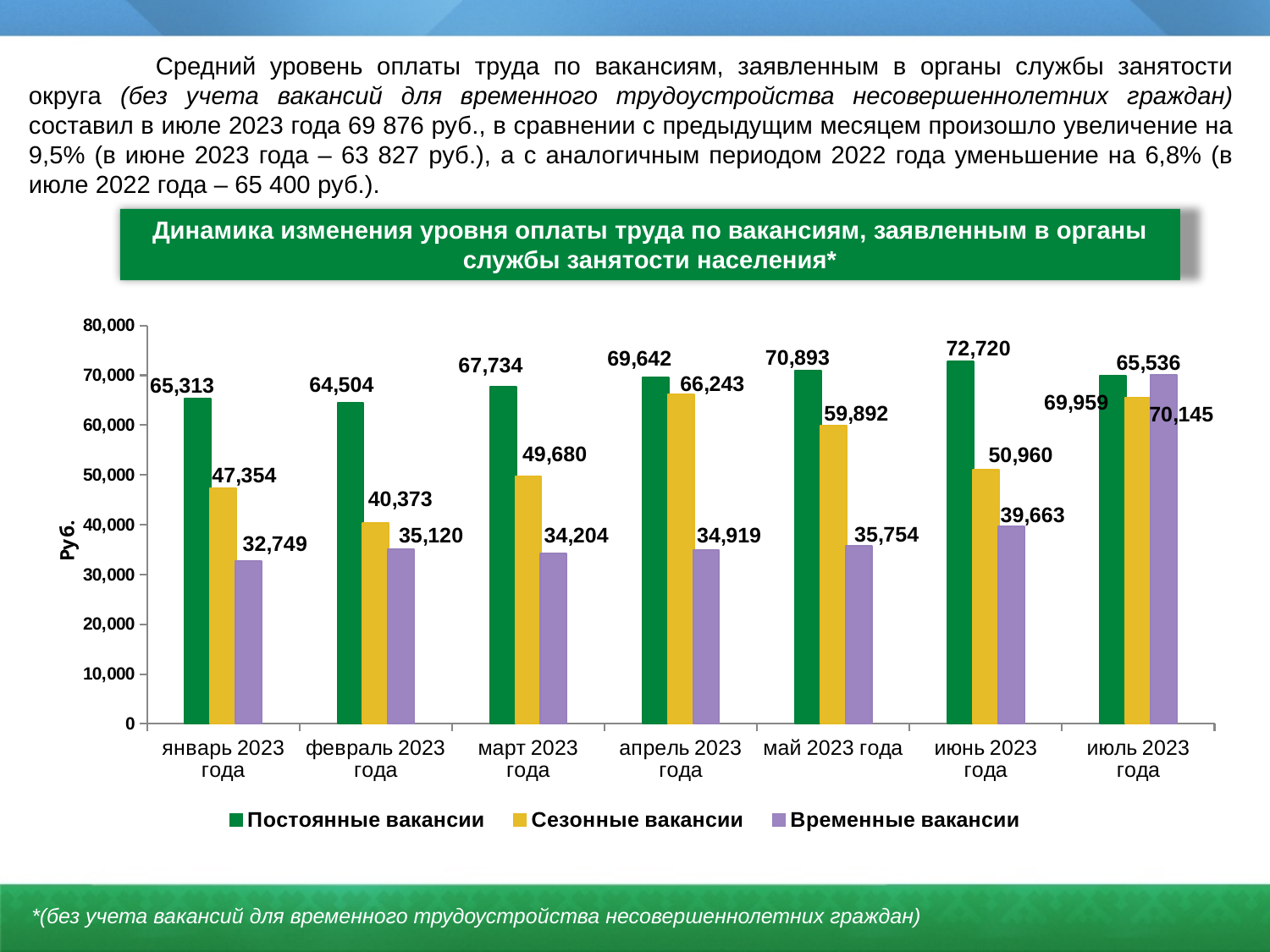
What is the value for Сезонные вакансии in июль 2023 года? 65,536 What is the difference between the Постоянные вакансии values for июнь 2023 года and июль 2023 года? 2,761 What kind of chart is shown on the slide? bar chart In which month is the value for Постоянные вакансии the highest? июнь 2023 года How many series does the legend list? 3 In which month is the value for Временные вакансии the lowest? январь 2023 года How many months are shown on the x axis? 7 What is the value for Временные вакансии in июнь 2023 года? 39,663 Do the values for Временные вакансии rise or fall from апрель 2023 года to июль 2023 года? rise What is the difference between Постоянные вакансии and Сезонные вакансии in январь 2023 года? 17,959 What is the value for Постоянные вакансии in март 2023 года? 67,734 Which month has the larger value for Сезонные вакансии: апрель 2023 года or май 2023 года? апрель 2023 года